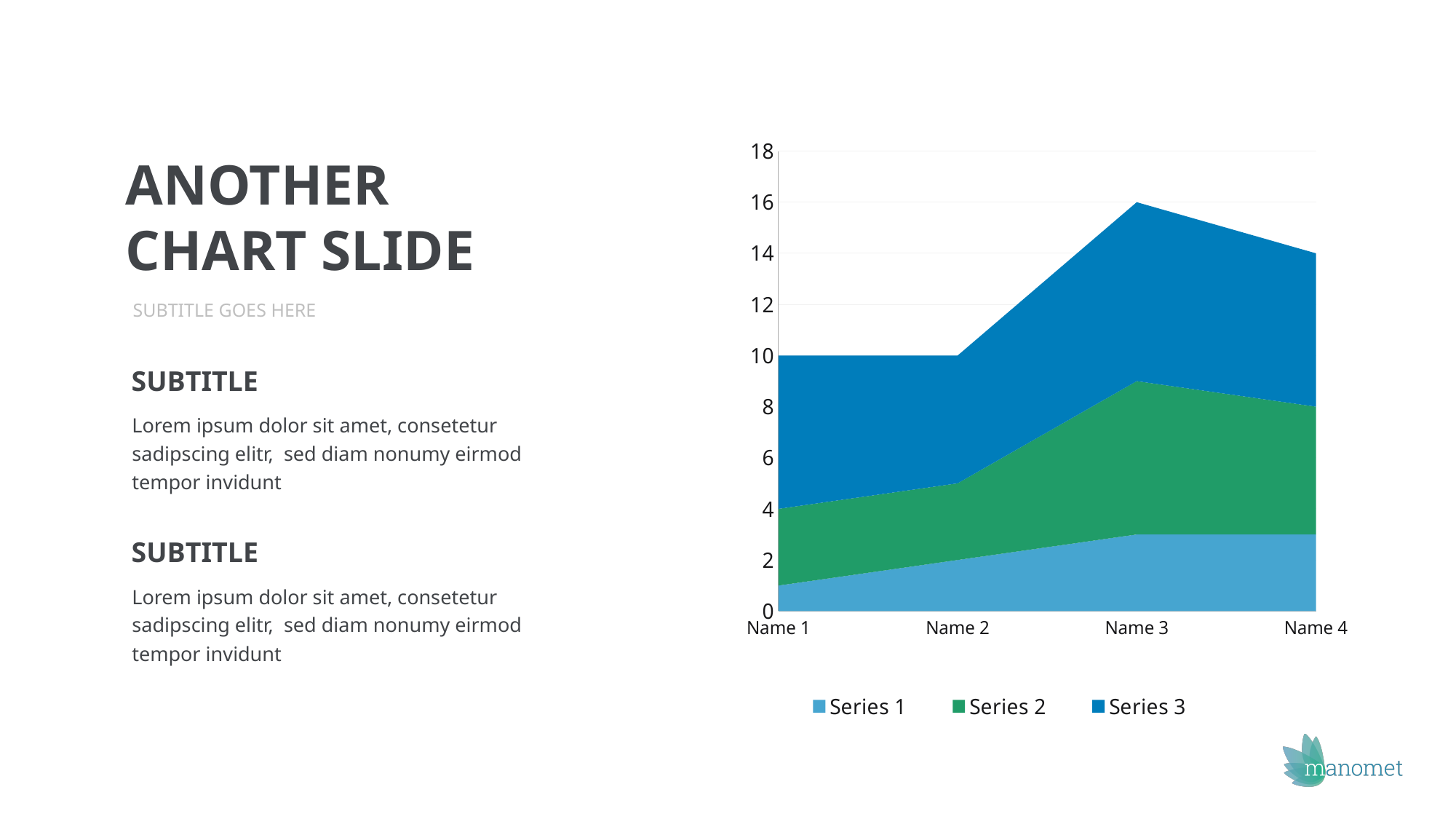
How many series does the chart's legend list? 3 What is the total stacked value at Name 4? 14 What is the total stacked value at Name 1? 10 How many categories are shown on the x axis of the chart? 4 Is the total stacked value larger at Name 3 or at Name 4? Name 3 Which category has the highest total stacked value? Name 3 What kind of chart is shown on the slide? Stacked area chart Is the total stacked value at Name 2 greater or less than 12? less What is the difference between the total stacked value at Name 3 and at Name 4? 2 Which series is shown in the darkest blue at the top of the stack? Series 3 What is the total stacked value at Name 3? 16 Is the value for Series 1 at Name 3 greater or less than 2? greater